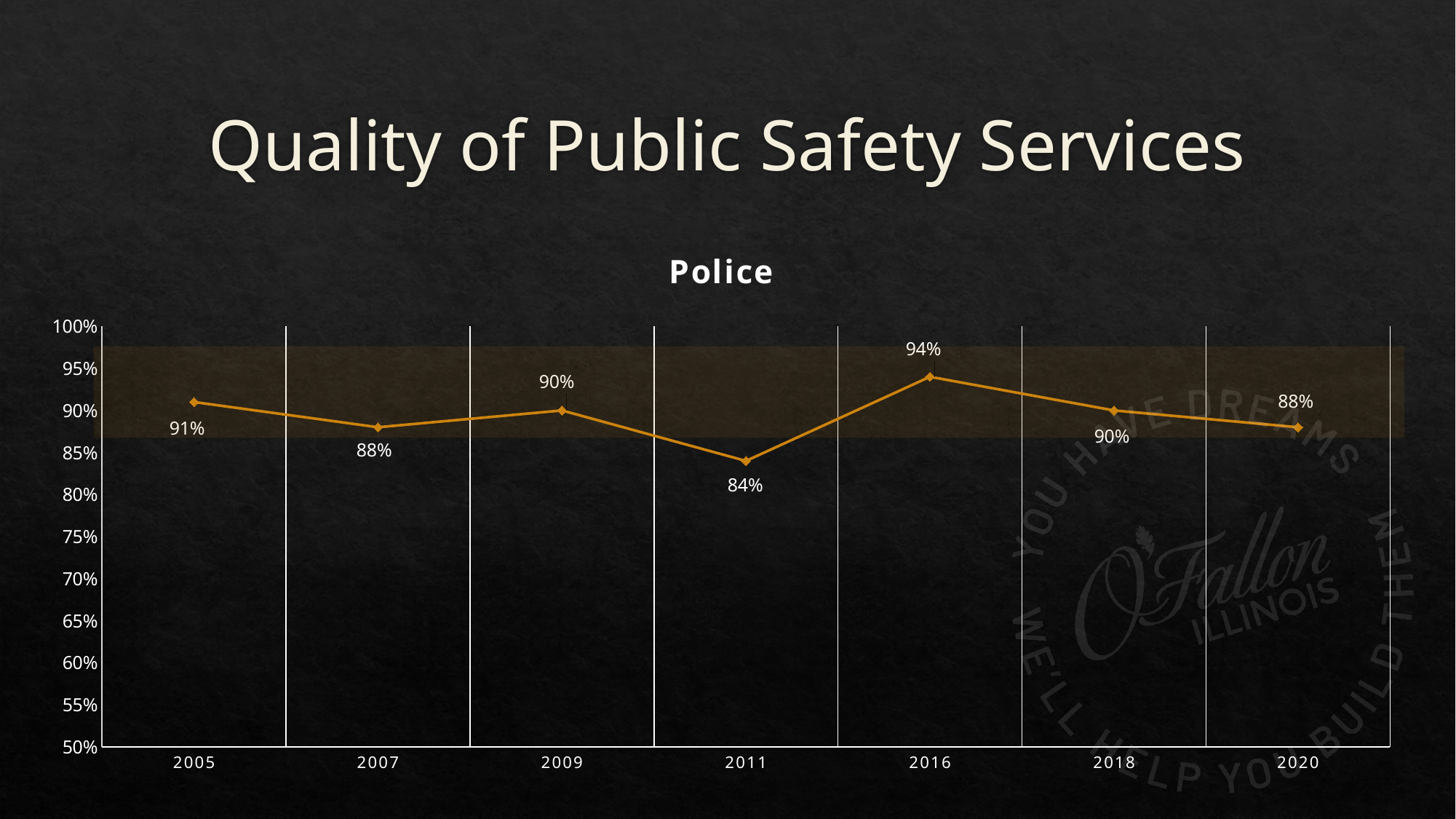
Which is larger, the value for 2005 or the value for 2007? 2005 Which year has the highest value? 2016 What is the value for 2020? 88% What kind of chart is shown? line chart What is the title of the chart? Police How many years are plotted on the chart? 7 What is the value for 2016? 94% What is the value for 2005? 91% Does the value rise or fall from 2011 to 2016? rise What is the value for 2011? 84% What is the difference between the values for 2016 and 2011? 10% Which year has the lowest value? 2011